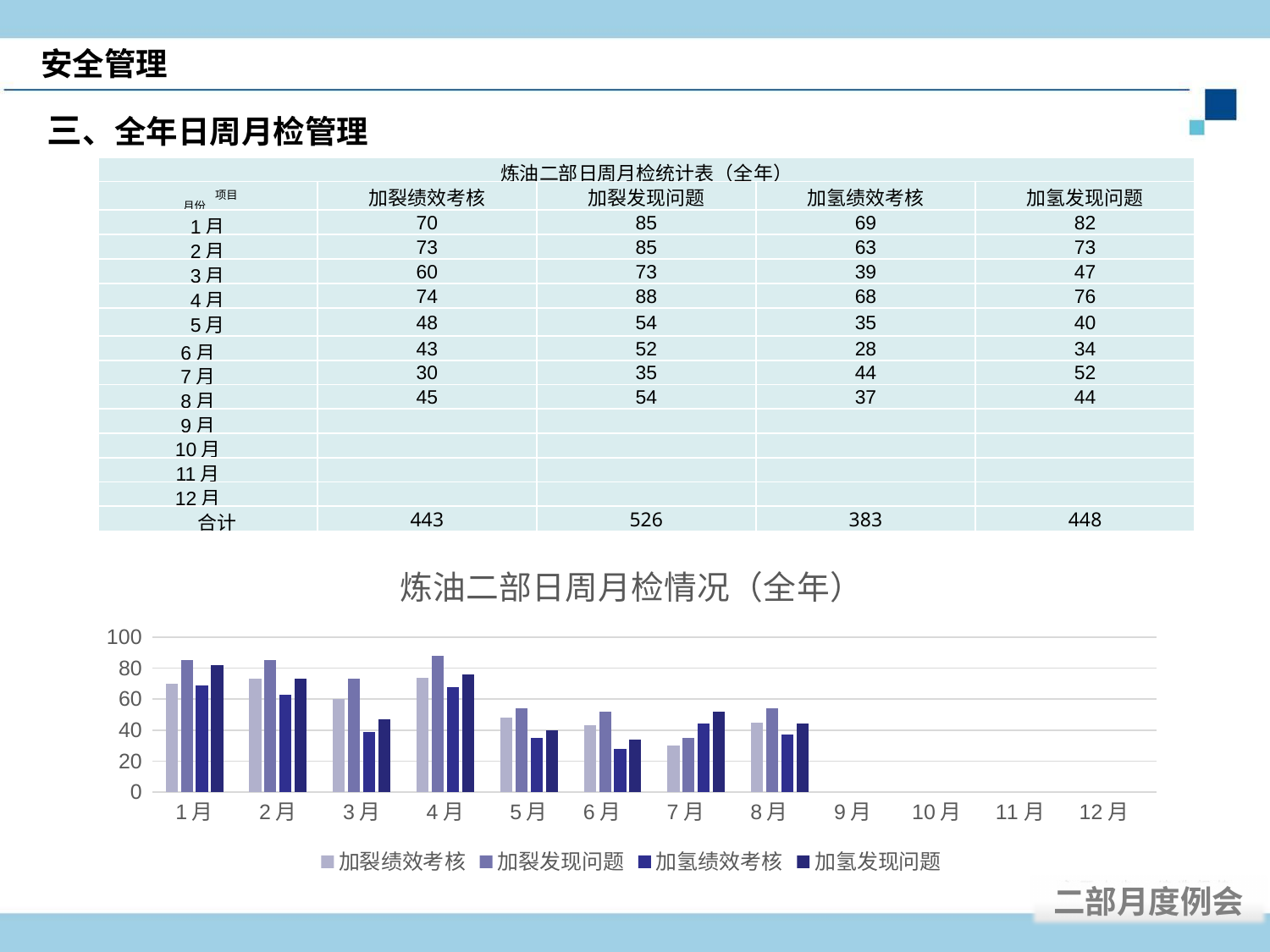
How many series does the chart legend list? 4 In the chart, is the value for 加裂发现问题 in 4月 greater or less than 80? greater In the chart, is the value for 加氢绩效考核 in 6月 greater or less than 40? less Which month has the lowest value for 加裂绩效考核? 7月 What kind of chart is shown on the slide? bar chart In 4月, what is the difference between 加裂发现问题 and 加氢绩效考核? 20 Which month has the highest value for 加裂发现问题? 4月 What is the value of 加裂绩效考核 in 1月? 70 What is the title of the chart? 炼油二部日周月检情况（全年） In 7月, which is larger: 加氢发现问题 or 加裂绩效考核? 加氢发现问题 How many month categories are shown on the x axis of the chart? 12 Does the value for 加裂绩效考核 rise or fall from 4月 to 7月? fall